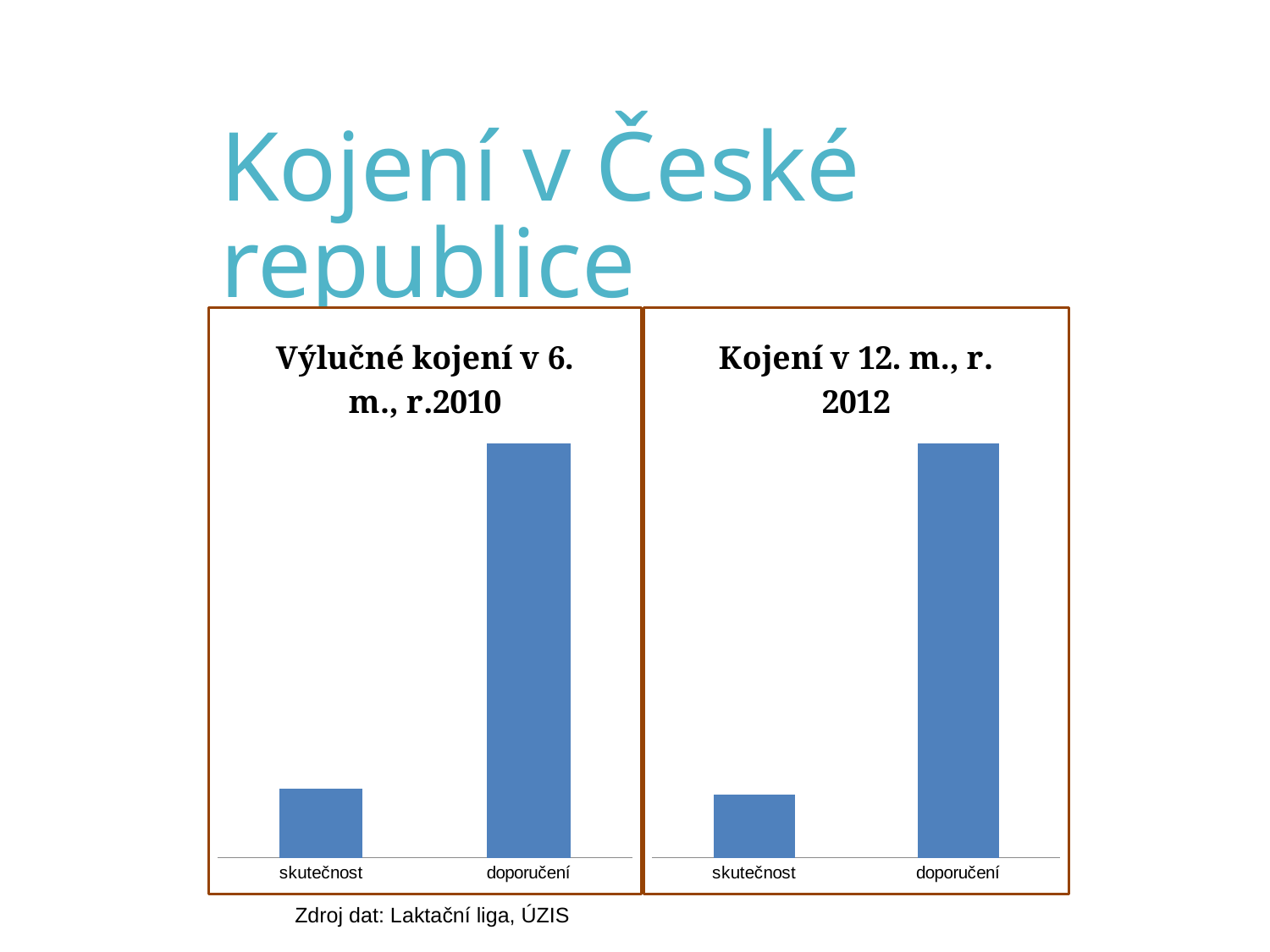
In the chart titled "Výlučné kojení v 6. m., r.2010", which category has the highest bar? doporučení What kind of chart is the left chart on the slide? bar chart How many categories are shown in the chart titled "Kojení v 12. m., r. 2012"? 2 In the chart titled "Kojení v 12. m., r. 2012", which category has the lowest bar? skutečnost How many categories are shown in the chart titled "Výlučné kojení v 6. m., r.2010"? 2 In the left chart, is the bar for skutečnost or doporučení taller? doporučení What is the title of the right chart on the slide? Kojení v 12. m., r. 2012 In the right chart, is the bar for skutečnost or doporučení taller? doporučení What kind of chart is the right chart on the slide? bar chart What is the title of the left chart on the slide? Výlučné kojení v 6. m., r.2010 In the chart titled "Výlučné kojení v 6. m., r.2010", which category has the lowest bar? skutečnost In the chart titled "Kojení v 12. m., r. 2012", which category has the highest bar? doporučení